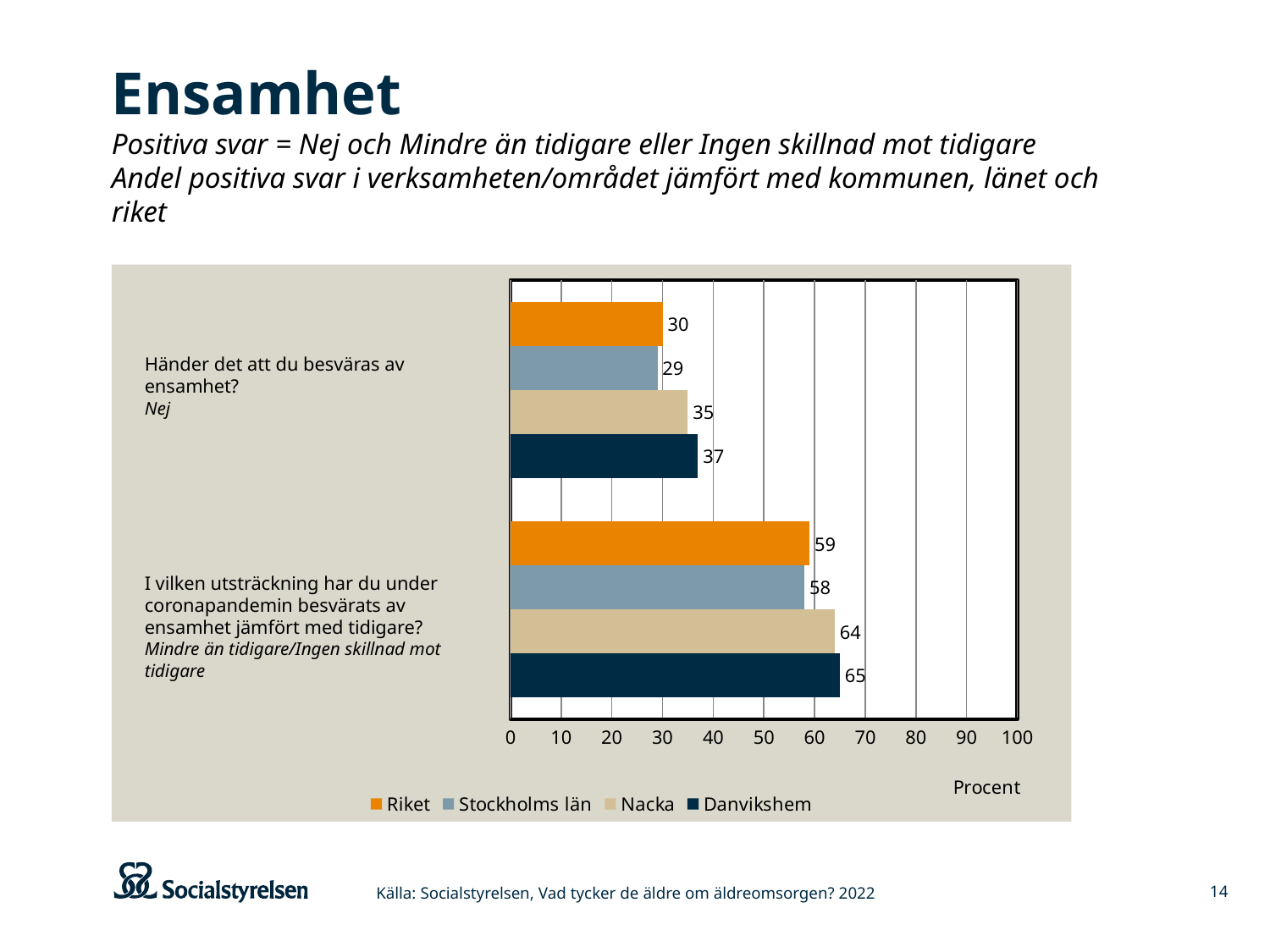
How many series does the legend list? 4 What unit is shown on the horizontal axis of the chart? Procent What is the value for Stockholms län on the question "Händer det att du besväras av ensamhet?"? 29 What is the value for Riket on the question "I vilken utsträckning har du under coronapandemin besvärats av ensamhet jämfört med tidigare?"? 59 What kind of chart is shown on the slide? Bar chart Which series has the highest value on the question "I vilken utsträckning har du under coronapandemin besvärats av ensamhet jämfört med tidigare?"? Danvikshem Is the value for Nacka on the question "I vilken utsträckning har du under coronapandemin besvärats av ensamhet jämfört med tidigare?" greater or less than 60? greater What is the value for Danvikshem on the question "Händer det att du besväras av ensamhet?"? 37 What is the difference between Danvikshem and Stockholms län on the question "I vilken utsträckning har du under coronapandemin besvärats av ensamhet jämfört med tidigare?"? 7 Which series has the lowest value on the question "Händer det att du besväras av ensamhet?"? Stockholms län Which is larger on the question "Händer det att du besväras av ensamhet?": Nacka or Danvikshem? Danvikshem What is the difference between Nacka and Riket on the question "Händer det att du besväras av ensamhet?"? 5